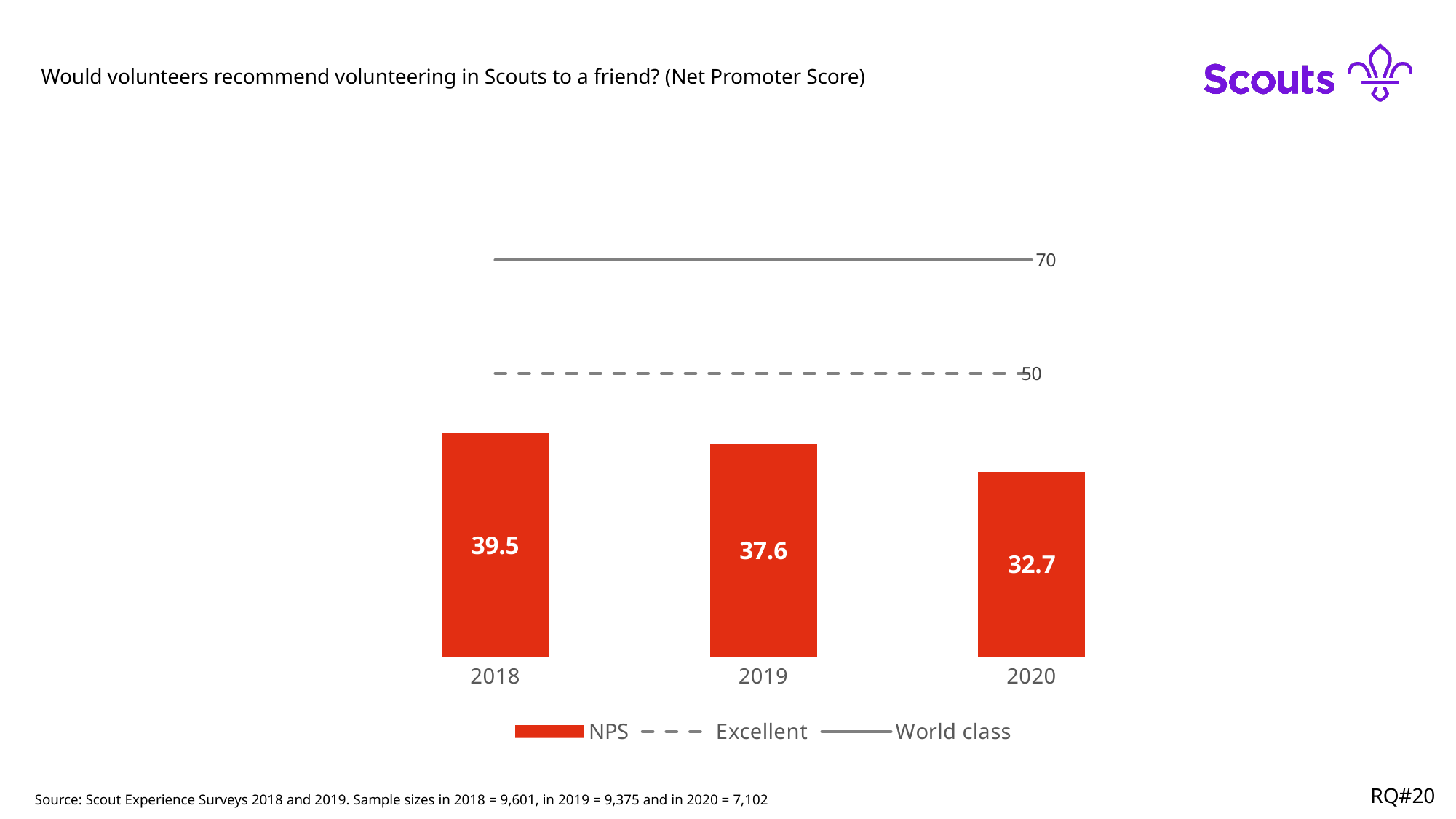
How many years are shown on the x axis? 3 What is the NPS value for 2020? 32.7 What is the NPS value for 2018? 39.5 Which is larger, the NPS for 2019 or the NPS for 2020? 2019 What is the NPS value for 2019? 37.6 How many series does the legend list? 3 What is the difference between the NPS in 2018 and the NPS in 2020? 6.8 Does the NPS rise or fall from 2018 to 2020? fall What kind of chart is used to show the NPS values? bar chart Is the NPS for 2018 greater or less than 50? less Which year has the lowest NPS? 2020 Which year has the highest NPS? 2018